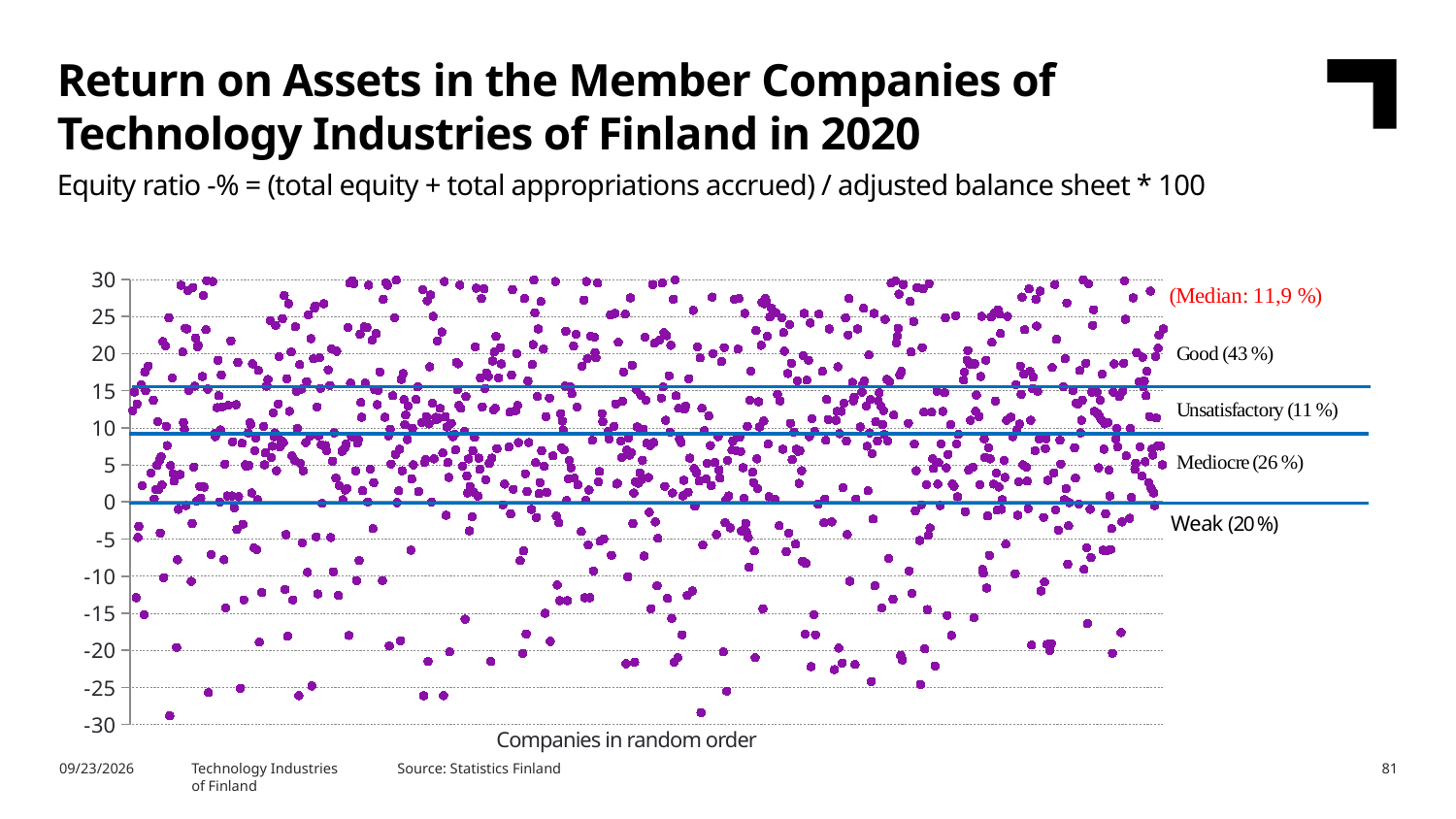
Which category has a larger share of companies, Mediocre or Weak? Mediocre Which category has the largest share of companies? Good What kind of chart is shown on the slide? scatter chart What is the median return on assets shown on the chart? 11,9 % Which category has the smallest share of companies? Unsatisfactory Is the median return on assets greater or less than 10? greater What share of companies falls into the Unsatisfactory category? 11 % What is the difference in percentage points between the Good share and the Weak share? 23 What share of companies falls into the Good category? 43 % What share of companies falls into the Weak category? 20 % What share of companies falls into the Mediocre category? 26 % What is the label of the horizontal axis? Companies in random order